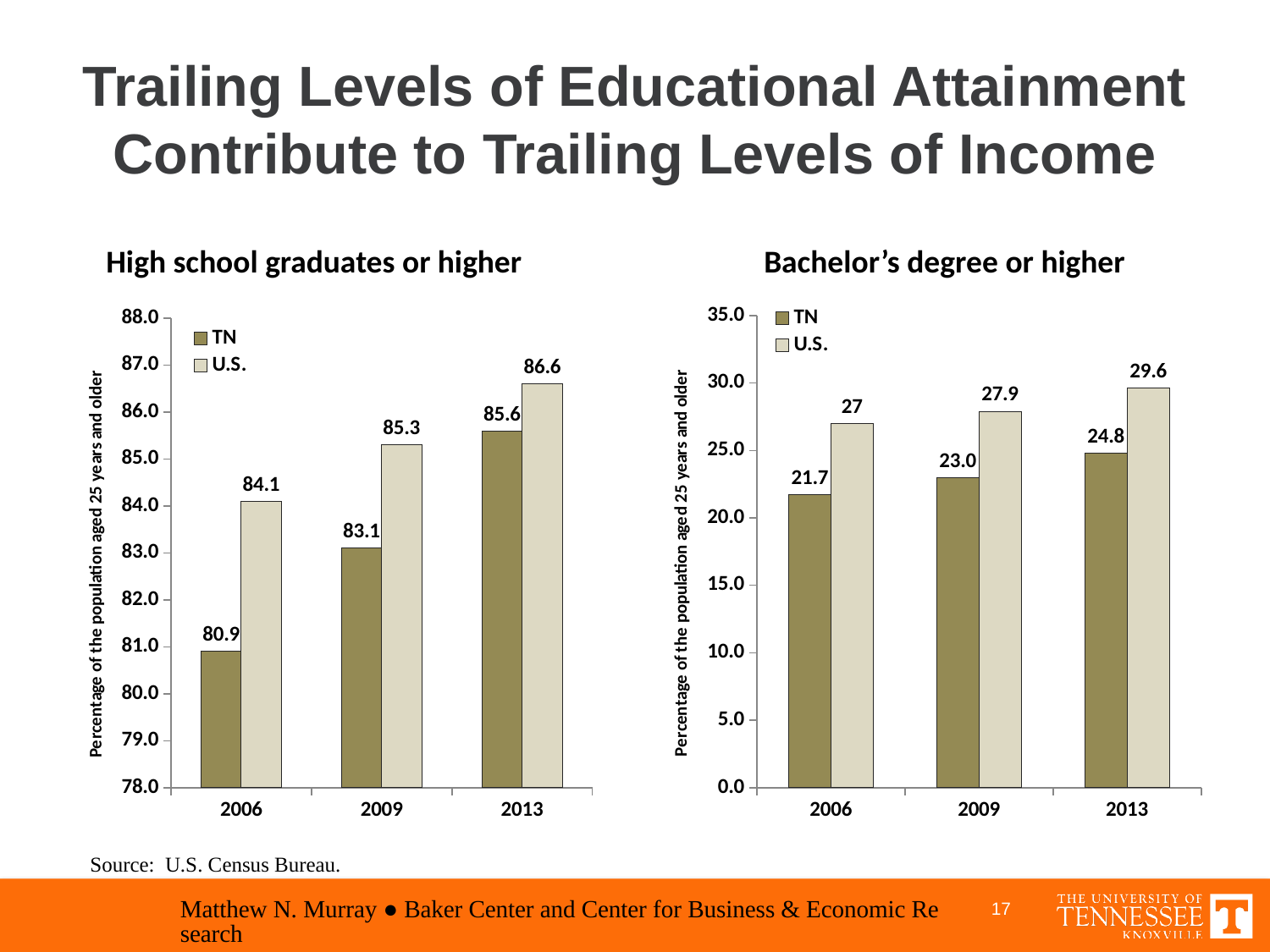
In the 'Bachelor's degree or higher' chart, what is the difference between the U.S. and TN values in 2013? 4.8 In the 'Bachelor's degree or higher' chart, what is the value for TN in 2009? 23.0 In the 'High school graduates or higher' chart, what is the value for U.S. in 2013? 86.6 In the 'Bachelor's degree or higher' chart, what is the value for U.S. in 2006? 27 In the 'High school graduates or higher' chart, do the TN values rise or fall from 2006 to 2013? rise In the 'Bachelor's degree or higher' chart, which year has the highest U.S. value? 2013 In the 'High school graduates or higher' chart, what is the value for TN in 2006? 80.9 In the 'Bachelor's degree or higher' chart, is the TN value in 2006 greater or less than 25.0? less In the 'High school graduates or higher' chart, what is the difference between the U.S. and TN values in 2009? 2.2 In the 'High school graduates or higher' chart, which year has the lowest TN value? 2006 How many series does the legend of the 'Bachelor's degree or higher' chart list? 2 What kind of chart is the 'High school graduates or higher' chart? bar chart